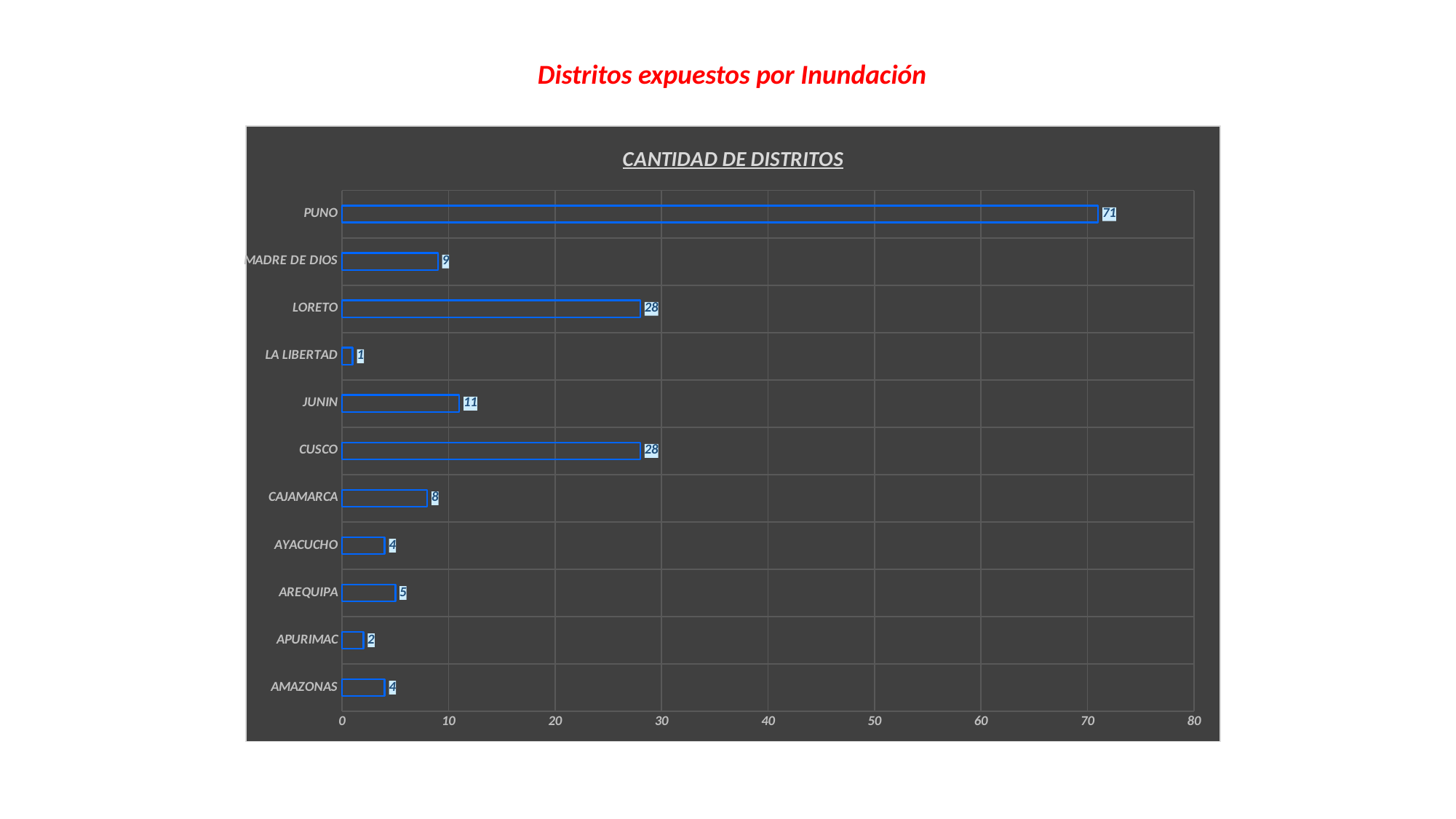
What is the value for LORETO? 28 What is the value for CAJAMARCA? 8 Which category has the lowest value? LA LIBERTAD What is the title of the chart? CANTIDAD DE DISTRITOS Which is larger, the value for MADRE DE DIOS or the value for AREQUIPA? MADRE DE DIOS What is the value for PUNO? 71 What is the difference between the values for PUNO and CUSCO? 43 How many categories are shown on the chart? 11 Which category has the highest value? PUNO Is the value for PUNO greater or less than 60? greater What kind of chart is shown? bar chart What is the value for JUNIN? 11